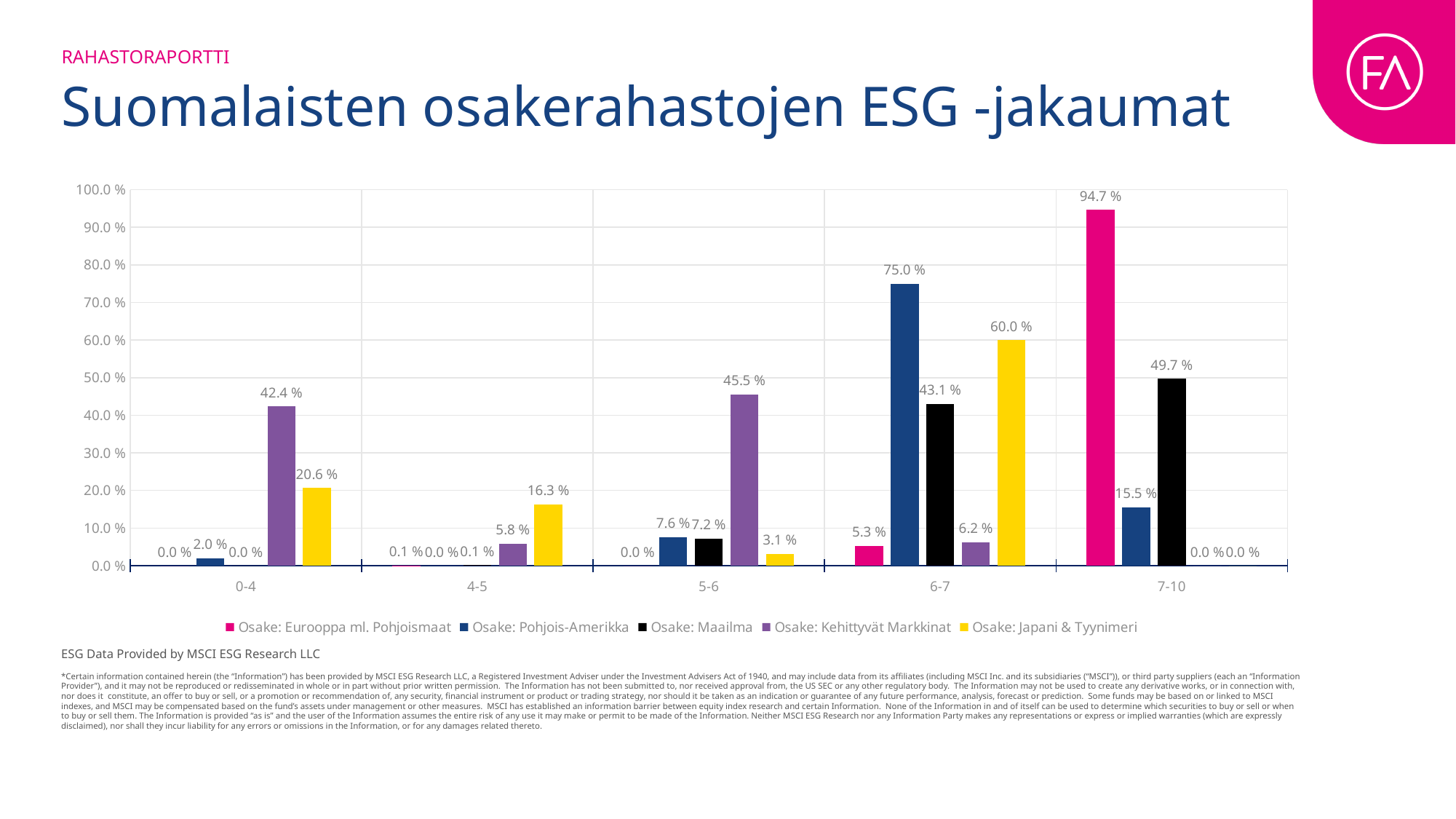
In which category does Osake: Maailma have its highest value? 7-10 What is the value for Osake: Pohjois-Amerikka in the 6-7 category? 75.0 % What is the value for Osake: Eurooppa ml. Pohjoismaat in the 7-10 category? 94.7 % How many categories are shown on the x axis? 5 Which series has the lowest value in the 6-7 category? Osake: Eurooppa ml. Pohjoismaat Is the value for Osake: Japani & Tyynimeri in the 6-7 category greater or less than 50.0 %? greater What kind of chart is shown on the slide? Bar chart How many series does the legend list? 5 What is the value for Osake: Japani & Tyynimeri in the 4-5 category? 16.3 % Which is larger in the 0-4 category: Osake: Kehittyvät Markkinat or Osake: Japani & Tyynimeri? Osake: Kehittyvät Markkinat What is the value for Osake: Kehittyvät Markkinat in the 5-6 category? 45.5 % What is the difference between Osake: Pohjois-Amerikka and Osake: Maailma in the 6-7 category? 31.9 %